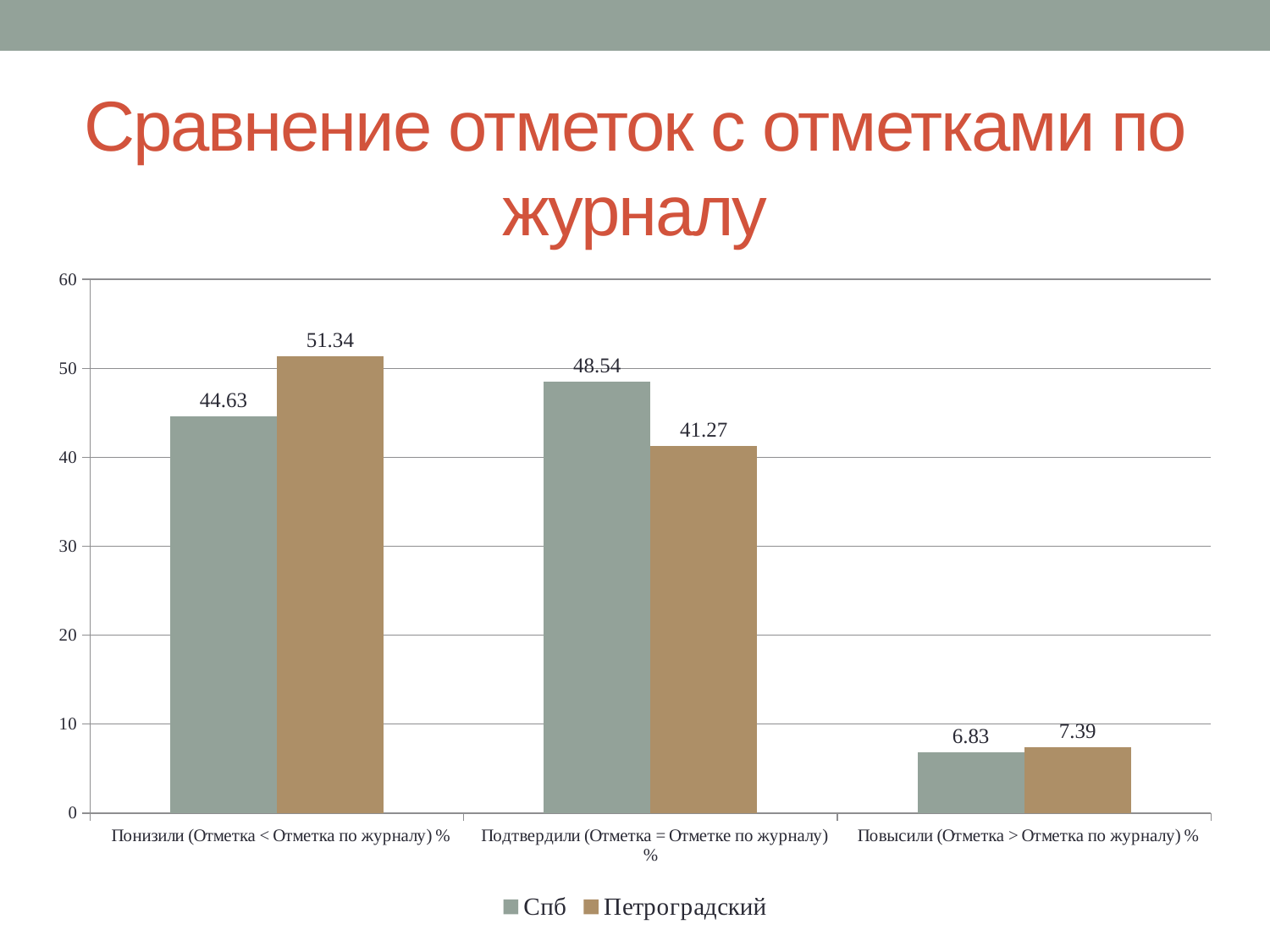
What value is shown for Спб in the category 'Понизили (Отметка < Отметка по журналу) %'? 44.63 What is the title of the slide? Сравнение отметок с отметками по журналу How many categories are shown on the x axis? 3 What is the difference between the Петроградский and Спб values in the category 'Понизили (Отметка < Отметка по журналу) %'? 6.71 Which category has the lowest value for the Спб series? Повысили (Отметка > Отметка по журналу) % How many series does the legend list? 2 What value is shown for Петроградский in the category 'Подтвердили (Отметка = Отметке по журналу) %'? 41.27 Is the Спб value for 'Повысили (Отметка > Отметка по журналу) %' greater or less than 10? less In the category 'Подтвердили (Отметка = Отметке по журналу) %', which series has the larger value, Спб or Петроградский? Спб What value is shown for Петроградский in the category 'Повысили (Отметка > Отметка по журналу) %'? 7.39 Which category has the highest value for the Петроградский series? Понизили (Отметка < Отметка по журналу) % What type of chart is shown on the slide? bar chart